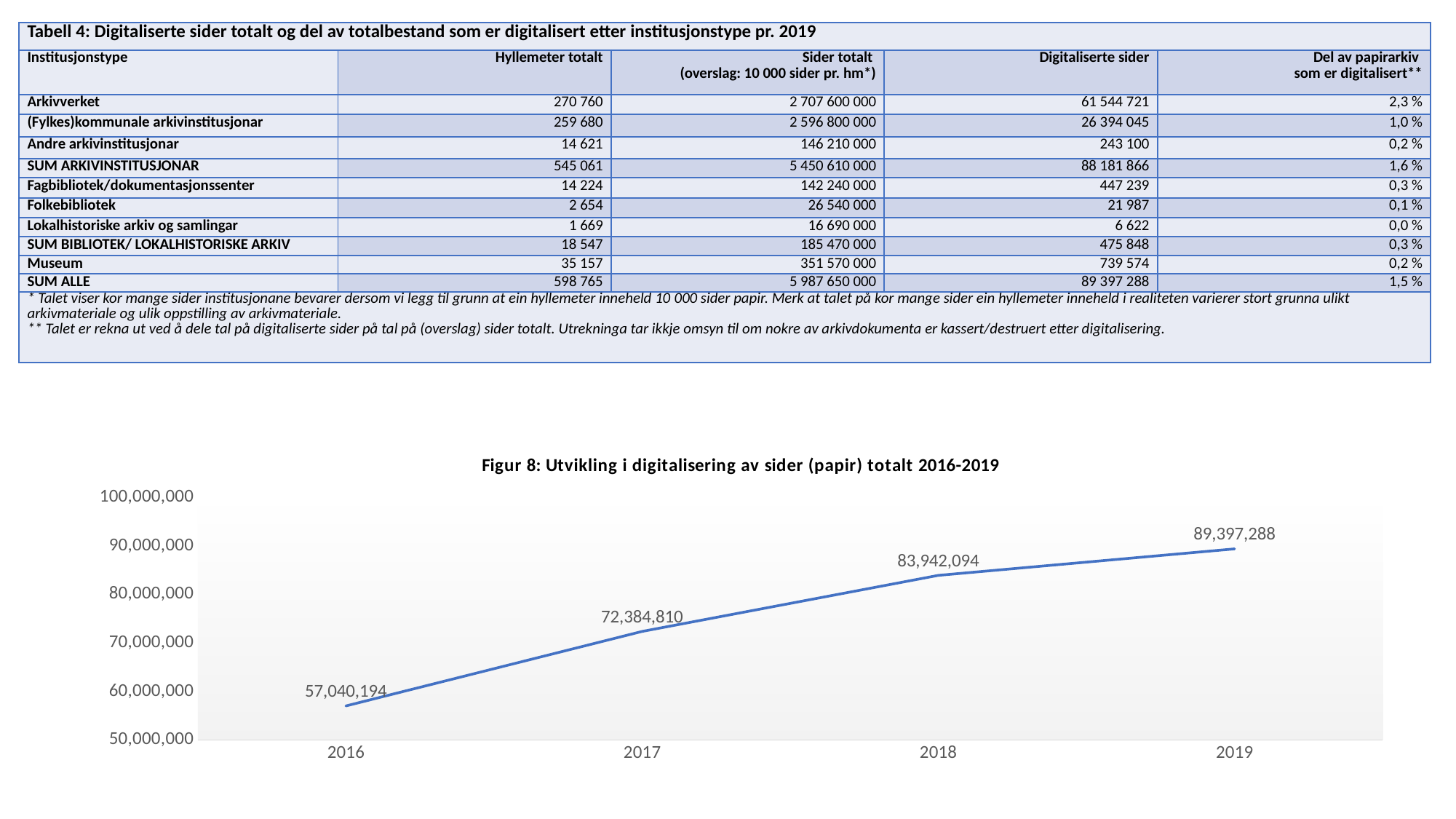
In Figur 8, is the value for 2017 greater or less than 70,000,000? greater How many data points are plotted in Figur 8? 4 What kind of chart is Figur 8? line chart In Figur 8, what is the difference between the values for 2018 and 2017? 11,557,284 In Figur 8, what is the value for 2019? 89,397,288 In Figur 8, which year has the lowest value? 2016 In Figur 8, what is the difference between the values for 2019 and 2016? 32,357,094 In Figur 8, do the values rise or fall from 2016 to 2019? rise In Figur 8, which year has the highest value? 2019 In Figur 8, what is the value for 2018? 83,942,094 In Figur 8, what is the value for 2016? 57,040,194 In Figur 8, what is the value for 2017? 72,384,810